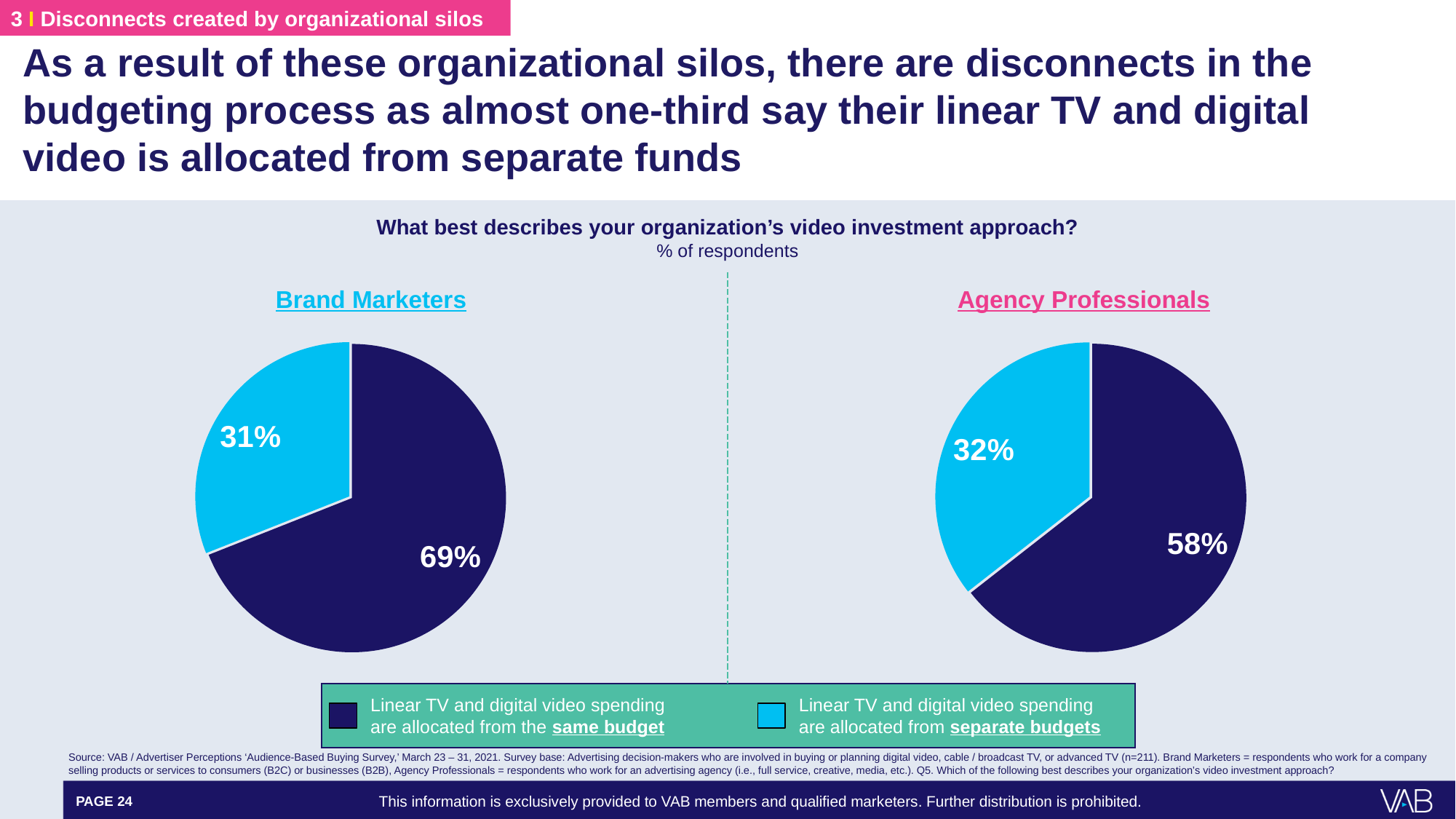
In the Brand Marketers pie chart, which slice is the largest? Linear TV and digital video spending are allocated from the same budget In the Agency Professionals pie chart, what percentage of respondents say linear TV and digital video spending are allocated from separate budgets? 32% Which is larger: the same budget share for Brand Marketers or the same budget share for Agency Professionals? Brand Marketers What type of chart is used for Brand Marketers? Pie chart In the Brand Marketers pie chart, what percentage of respondents say linear TV and digital video spending are allocated from the same budget? 69% In the Agency Professionals pie chart, which slice is the smallest? Linear TV and digital video spending are allocated from separate budgets In the Brand Marketers pie chart, what percentage of respondents say linear TV and digital video spending are allocated from separate budgets? 31% What is the difference between the same budget share and the separate budgets share in the Brand Marketers pie chart? 38 percentage points How many slices does the Agency Professionals pie chart have? 2 What colour represents spending allocated from separate budgets in the pie charts? Light blue In the Agency Professionals pie chart, what percentage of respondents say linear TV and digital video spending are allocated from the same budget? 58% How many entries does the shared legend list? 2